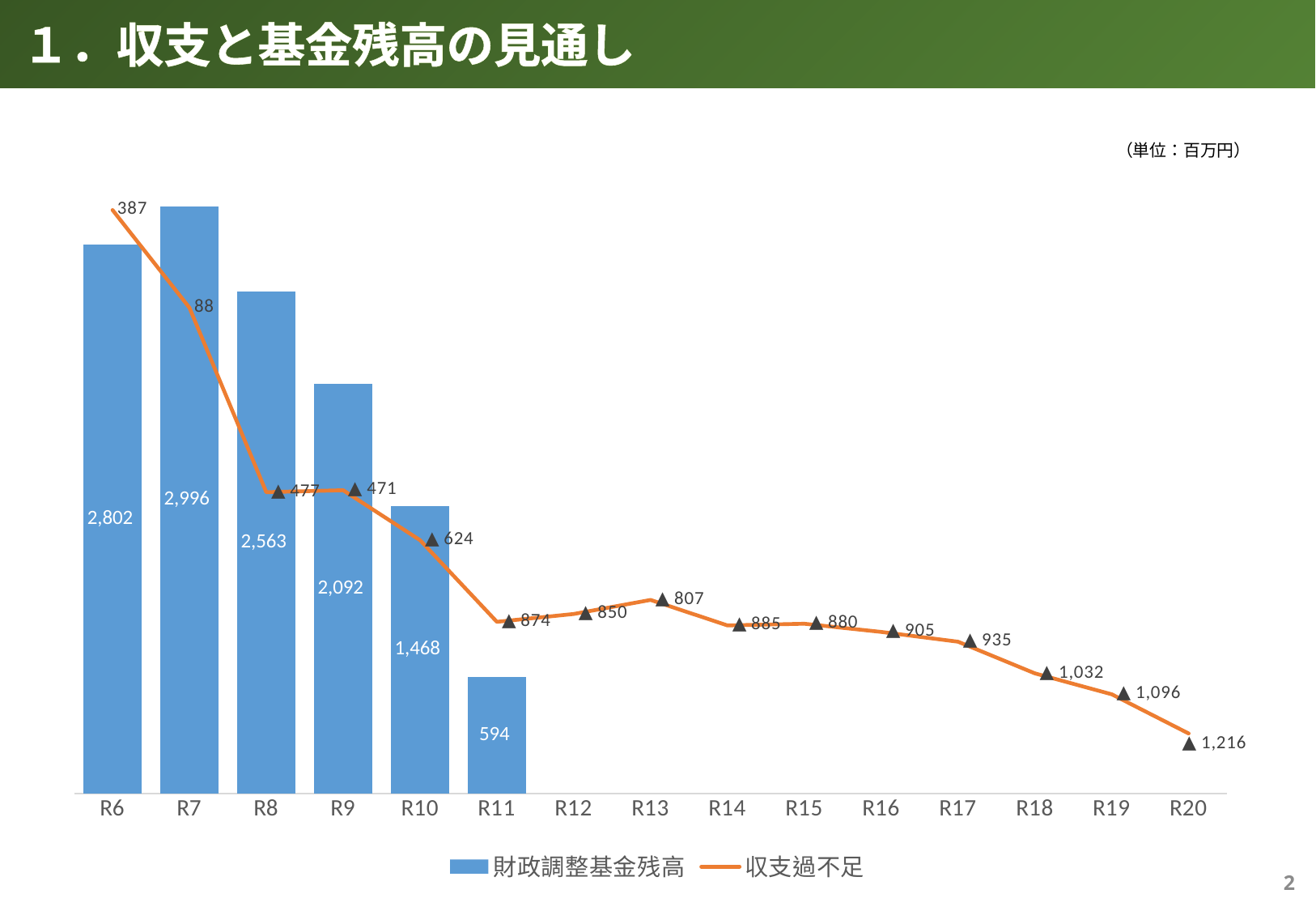
What is the value of 収支過不足 for R20? ▲1,216 What is the difference between the 財政調整基金残高 values for R7 and R6? 194 What is the value of 財政調整基金残高 for R7? 2,996 What is the value of 収支過不足 for R6? 387 Which year has the lowest 財政調整基金残高 bar? R11 How many years have a 財政調整基金残高 bar plotted? 6 Which is larger, the 財政調整基金残高 for R8 or for R9? R8 How many series does the legend list? 2 Do the 財政調整基金残高 bars rise or fall from R7 to R11? Fall How many categories are shown on the x axis? 15 Which year has the highest 財政調整基金残高 bar? R7 What kind of chart is this? Combined bar and line chart